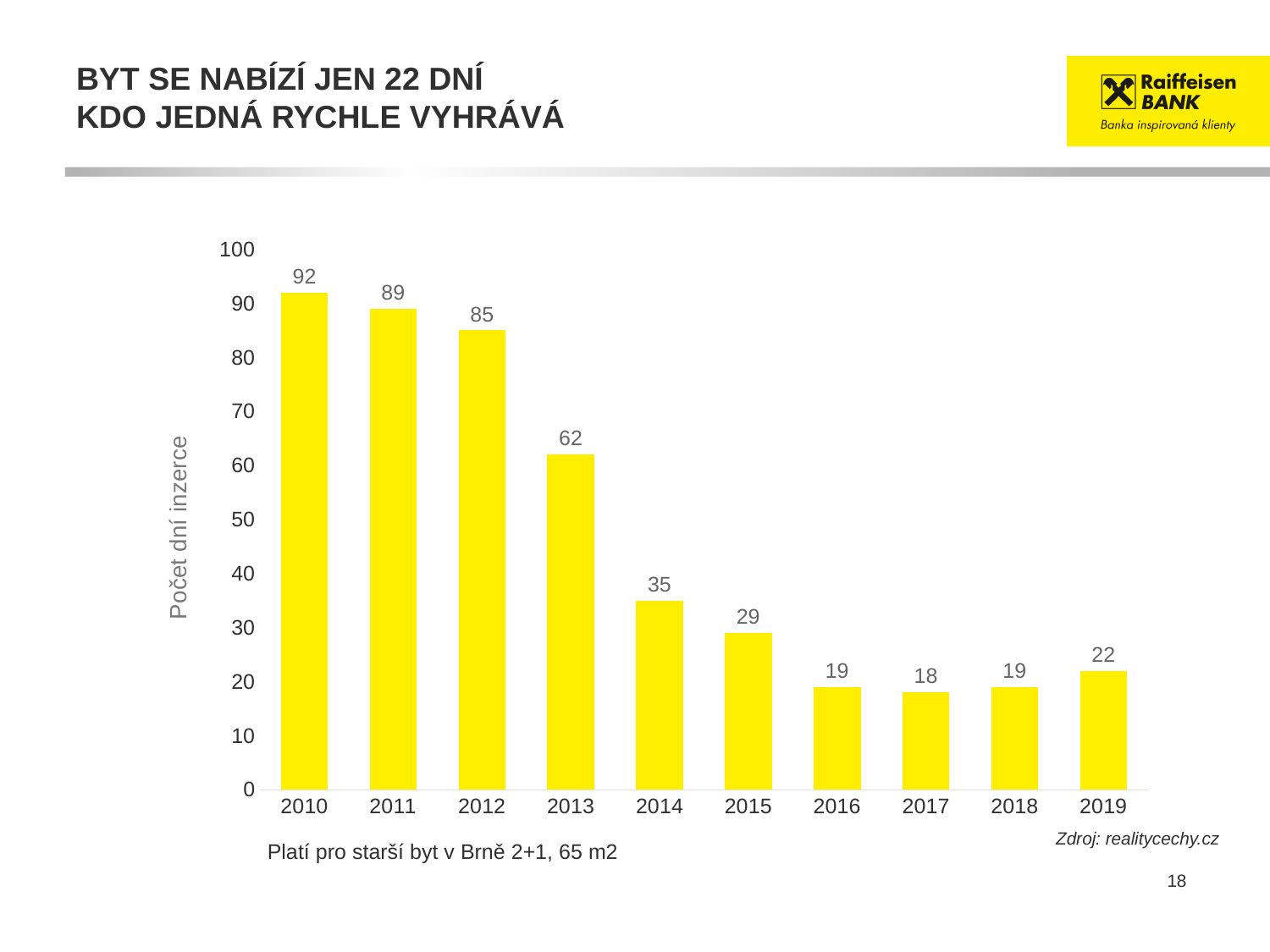
Which year has the highest value? 2010 What is the value for 2010? 92 What is the label of the vertical axis? Počet dní inzerce Which is larger, the value for 2012 or the value for 2015? 2012 How many years are shown on the x axis? 10 What is the difference between the values for 2010 and 2019? 70 Which year has the lowest value? 2017 What is the value for 2013? 62 What kind of chart is shown on the slide? bar chart Is the value for 2014 greater or less than 30? greater What is the difference between the values for 2013 and 2014? 27 What is the value for 2019? 22